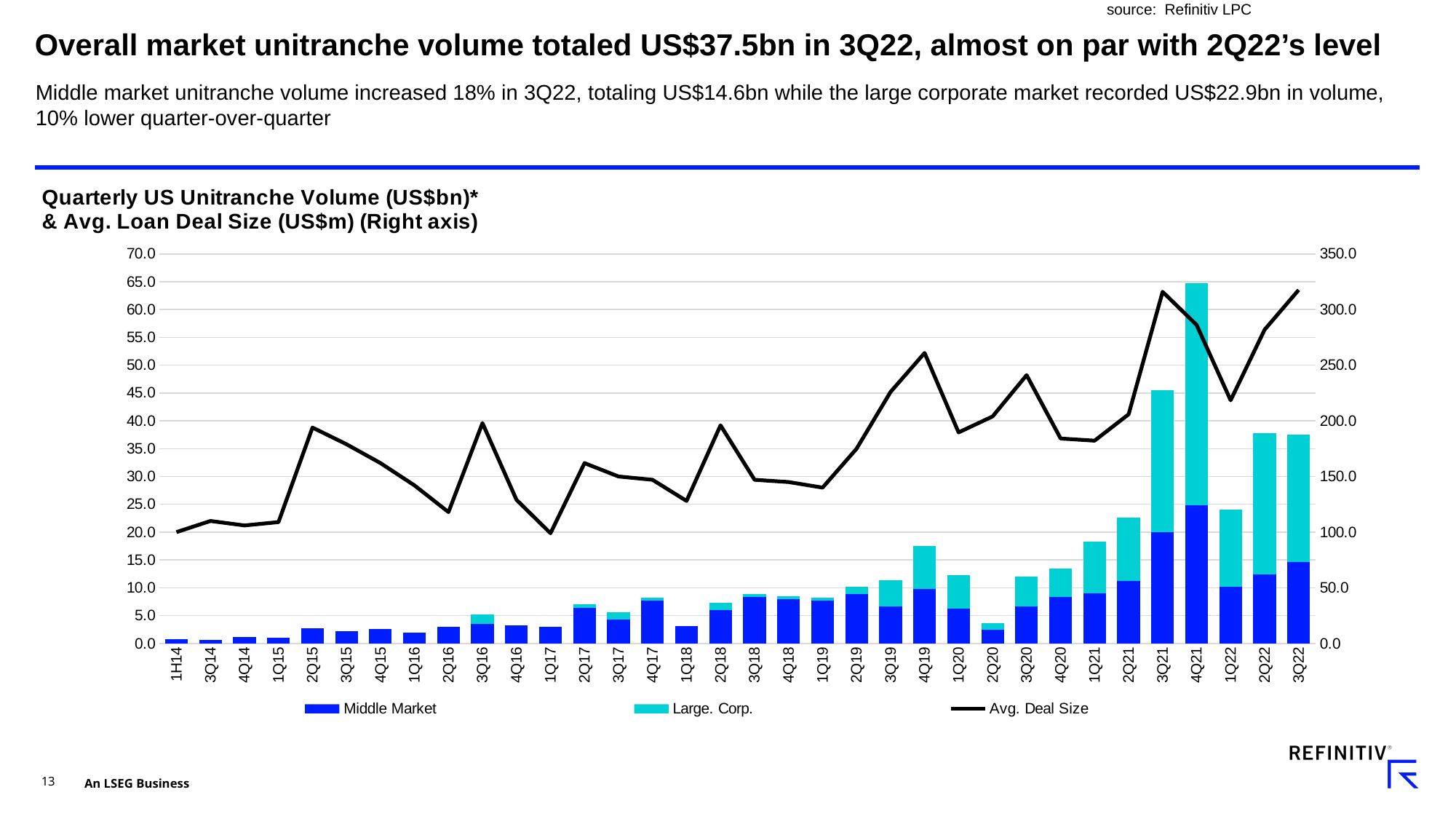
Which is larger, the Middle Market bar for 4Q21 or the Middle Market bar for 3Q21? 4Q21 Which period has the highest total unitranche volume bar? 4Q21 What kind of chart is shown on the slide? A stacked bar chart combined with a line chart Does the Avg. Deal Size line rise or fall from 1Q22 to 3Q22? Rise How many quarterly periods are shown on the x axis of the chart? 34 Is the Avg. Deal Size value for 3Q22 greater or less than 300.0 on the right axis? greater Which series in the legend is drawn as a black line? Avg. Deal Size Is the total unitranche volume bar for 2Q20 greater or less than 5.0? less Is the total unitranche volume bar for 4Q21 greater or less than 60.0? greater How many series does the chart legend list? 3 According to the slide, what was the overall market unitranche volume in 3Q22? US$37.5bn